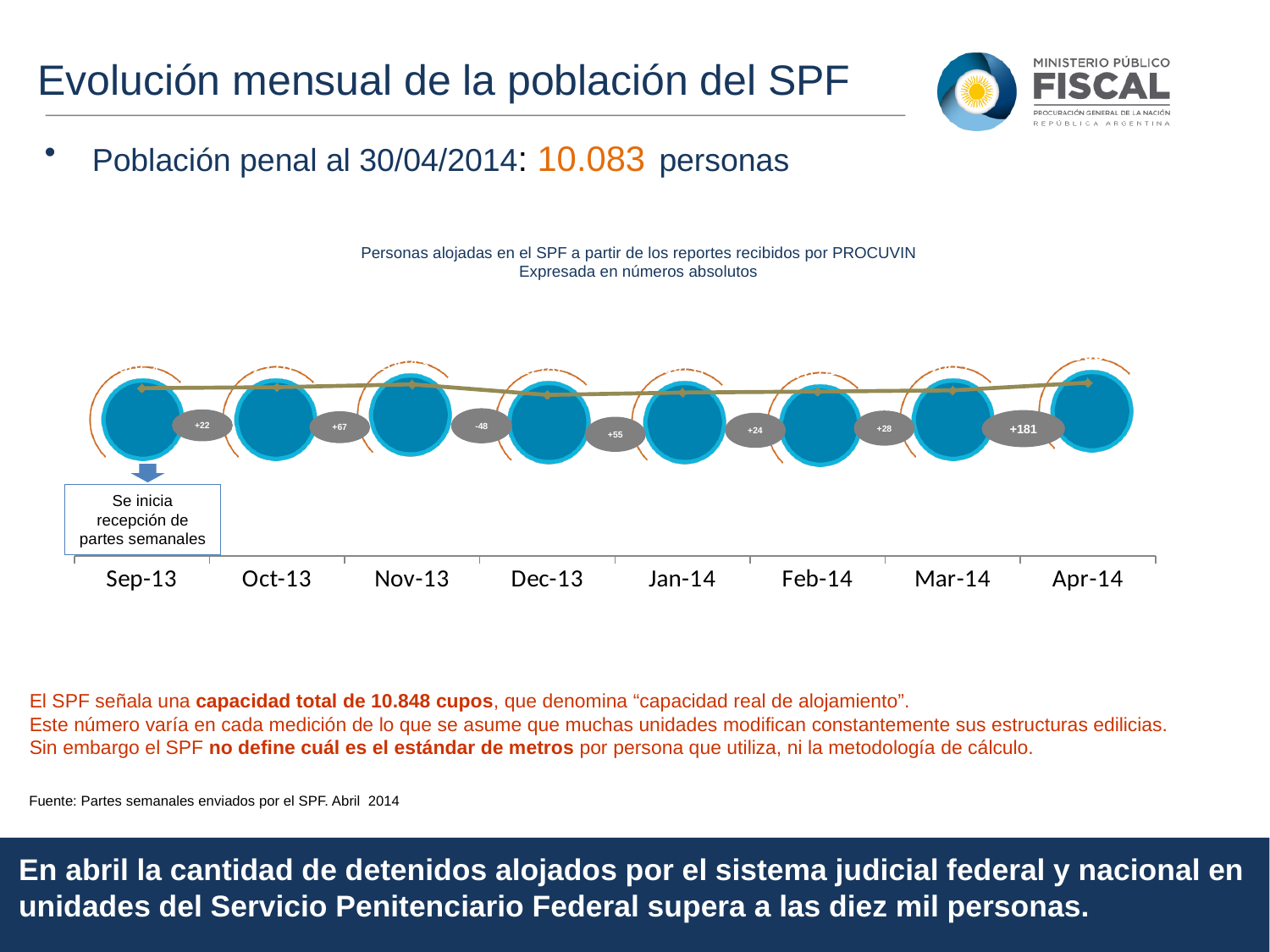
What annotation is attached to the Sep-13 point of the chart? Se inicia recepción de partes semanales Does the line rise or fall from Nov-13 to Dec-13? fall What is the last month shown on the x axis of the chart? Apr-14 What change is labelled between Sep-13 and Oct-13? +22 What change is labelled between Oct-13 and Nov-13? +67 What kind of chart is shown on the slide? line chart Which month-to-month change label is the only negative one? -48 (Nov-13 to Dec-13) What change is labelled between Nov-13 and Dec-13? -48 How many months are shown on the x axis of the chart? 8 What is the first month shown on the x axis of the chart? Sep-13 Which month-to-month change label has the largest value? +181 (Mar-14 to Apr-14) What change is labelled between Mar-14 and Apr-14? +181